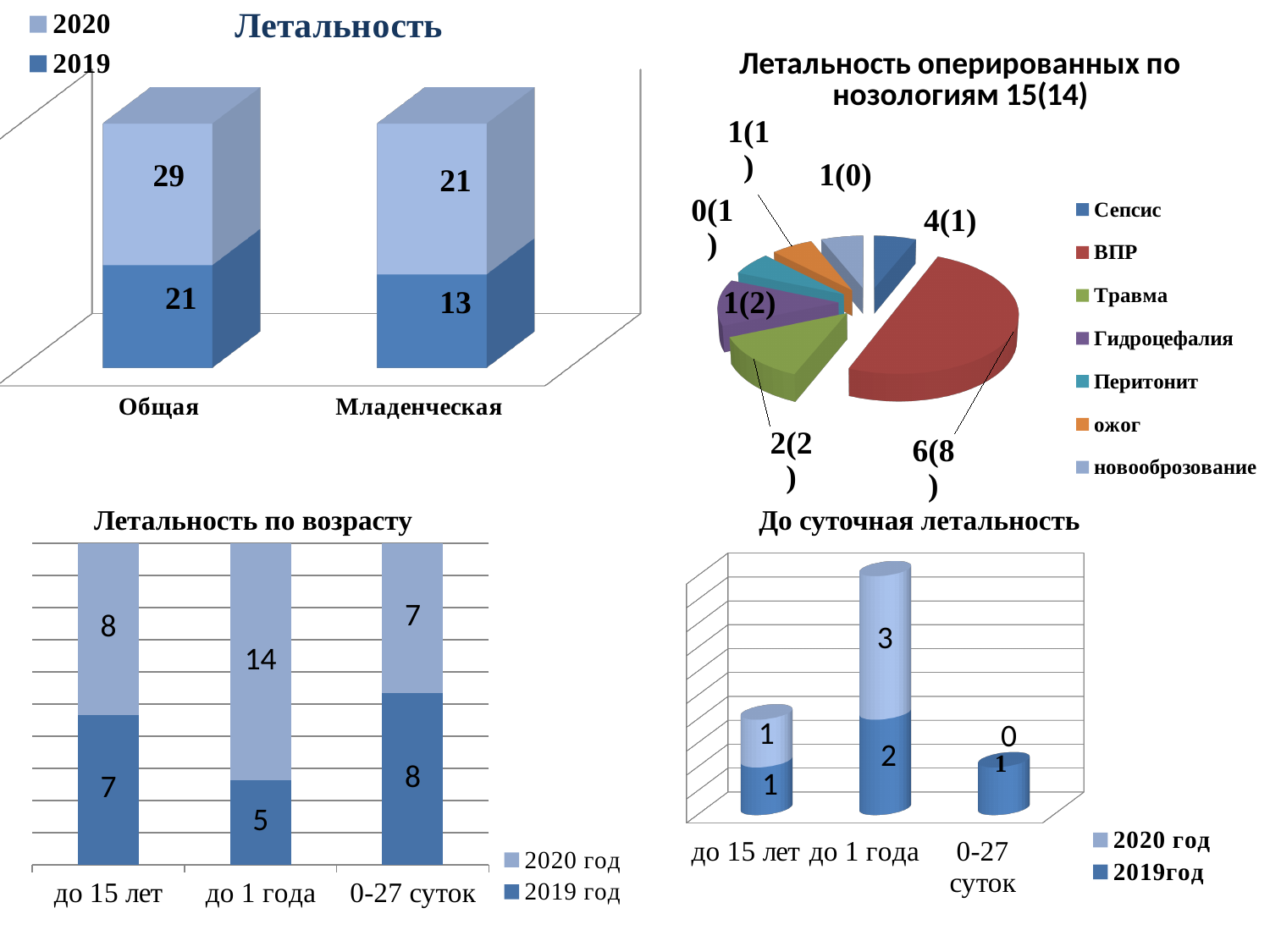
In the 'Летальность' chart, what is the total of the stacked bar for Общая? 50 In the 'Летальность' chart, what is the 2019 value for Младенческая? 13 In the 'До суточная летальность' chart, what is the 2020 год value for до 1 года? 3 In the 'Летальность по возрасту' chart, which category has the lowest 2019 год value? до 1 года In the 'Летальность оперированных по нозологиям 15(14)' chart, how many categories does the legend list? 7 In the 'Летальность по возрасту' chart, what is the 2020 год value for до 1 года? 14 What kind of chart is 'Летальность оперированных по нозологиям 15(14)'? pie chart In the 'Летальность' chart, what is the 2020 value for Общая? 29 In the 'Летальность' chart, what is the difference between the 2020 and 2019 values for Младенческая? 8 In the 'До суточная летальность' chart, which category has the highest 2019год value? до 1 года In the 'Летальность по возрасту' chart, what is the total of the stacked bar for 0-27 суток? 15 In the 'Летальность оперированных по нозологиям 15(14)' chart, what label is shown on the ВПР slice? 6(8)